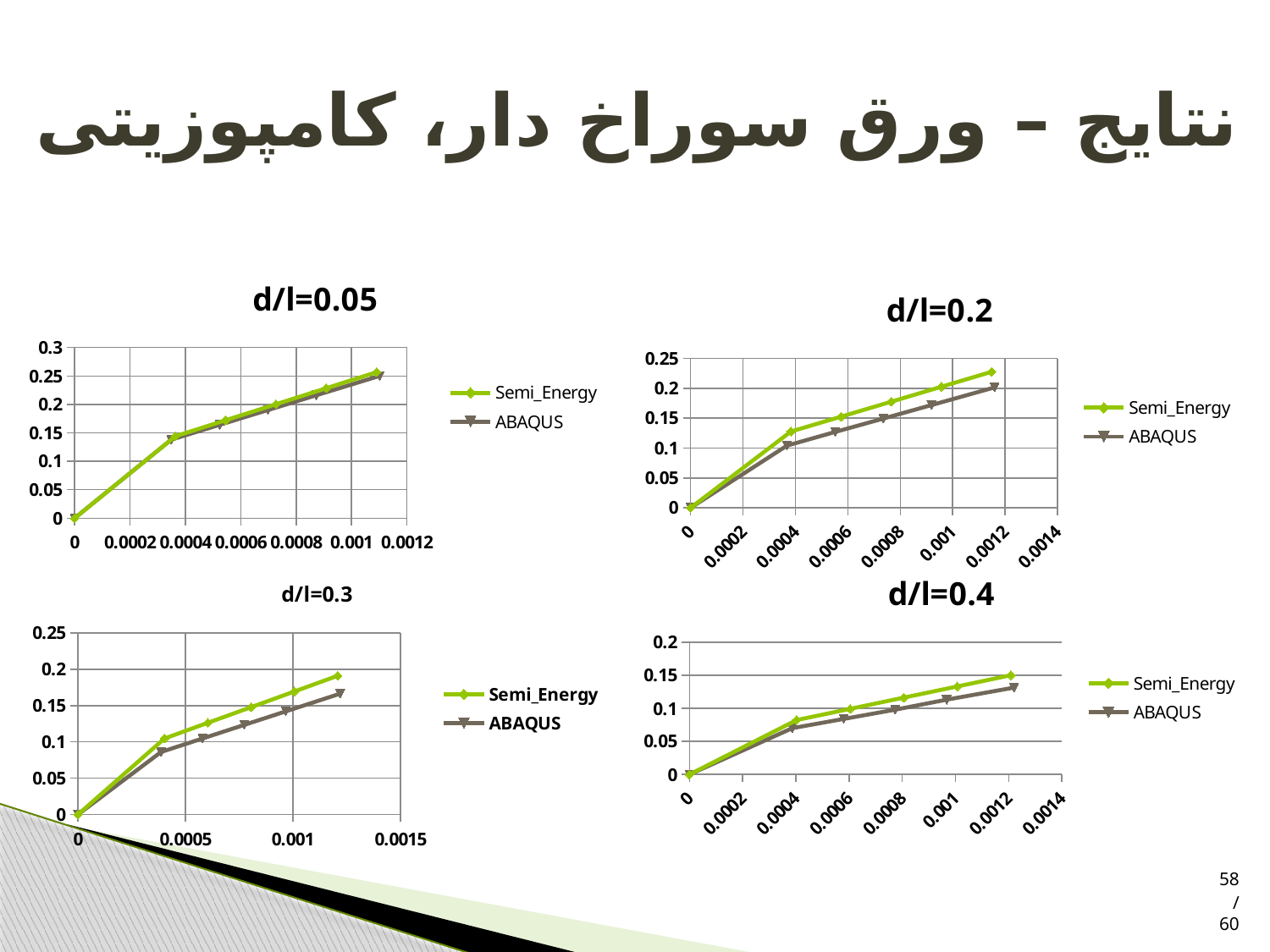
In the d/l=0.05 chart, is the last Semi_Energy value greater or less than 0.2? greater In the d/l=0.2 chart, at x=0.0004, which series has the larger value, Semi_Energy or ABAQUS? Semi_Energy In the d/l=0.3 chart, at the last plotted point, which series has the larger value, Semi_Energy or ABAQUS? Semi_Energy In the d/l=0.2 chart, is the final ABAQUS value greater or less than 0.25? less How many series does the legend of the d/l=0.2 chart list? 2 What is the title of the chart at the top right of the slide? d/l=0.2 What are the two series named in the legend of the d/l=0.3 chart? Semi_Energy and ABAQUS In the d/l=0.05 chart, what is the Semi_Energy value at x=0? 0 In the d/l=0.4 chart, is the highest Semi_Energy value greater or less than 0.2? less What kind of chart is the d/l=0.05 chart? line chart How many charts are shown on the slide? 4 In the d/l=0.4 chart, do the Semi_Energy values rise or fall as the x axis increases? rise